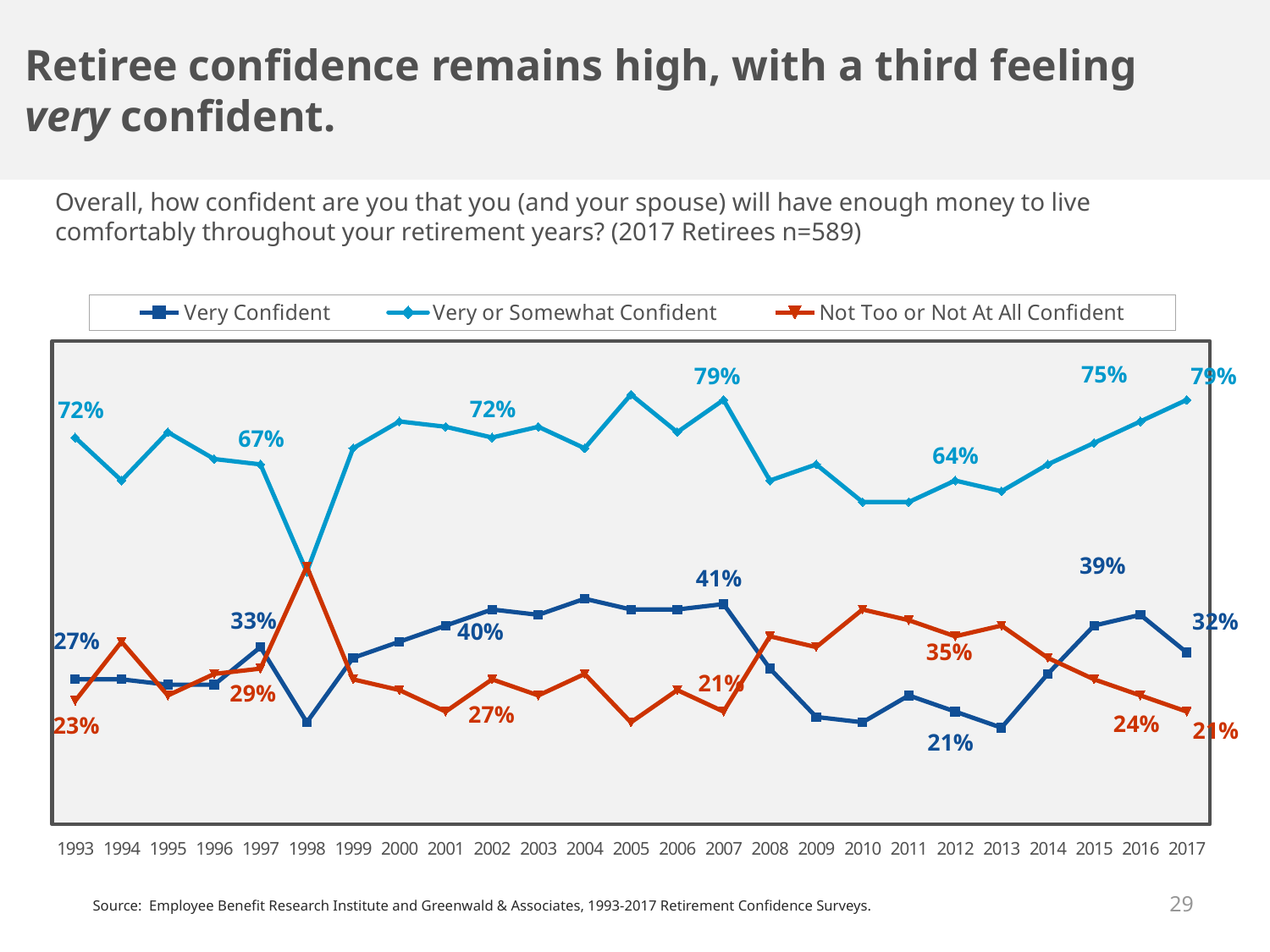
What is the value for Very Confident in 1993? 27% Does the Very or Somewhat Confident line rise or fall from 2012 to 2017? Rises What is the value for Very or Somewhat Confident in 2017? 79% In 2017, which is larger: Very Confident or Not Too or Not At All Confident? Very Confident Which series has the highest value in 2017? Very or Somewhat Confident What kind of chart is shown on the slide? Line chart What is the value for Very or Somewhat Confident in 2007? 79% What is the difference between the Very or Somewhat Confident values in 2017 and 1993? 7 percentage points What is the value for Not Too or Not At All Confident in 2017? 21% How many years are shown along the x axis? 25 How many series does the legend list? 3 What is the value for Very Confident in 2017? 32%